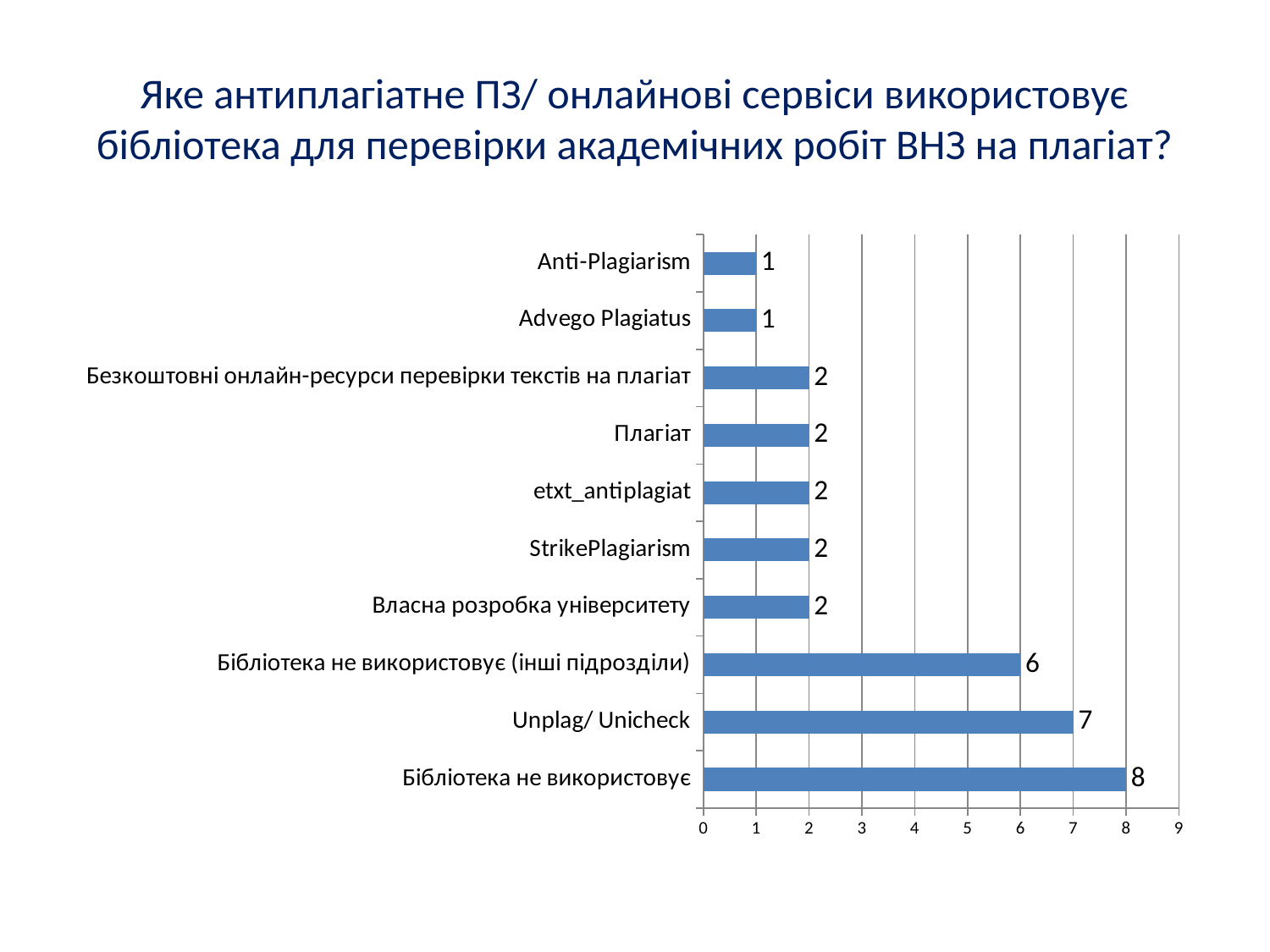
What kind of chart is shown on the slide? Bar chart What is the value for Unplag/ Unicheck? 7 What is the value for StrikePlagiarism? 2 Which category has the highest value? Бібліотека не використовує Which is larger, the value for Бібліотека не використовує (інші підрозділи) or the value for Власна розробка університету? Бібліотека не використовує (інші підрозділи) What is the value for Advego Plagiatus? 1 How many categories are shown in the chart? 10 What is the difference between the values for Бібліотека не використовує and Unplag/ Unicheck? 1 What is the difference between the values for Unplag/ Unicheck and Плагіат? 5 How many categories have a value of 2? 5 What is the highest value shown on the horizontal axis? 9 What is the value for Бібліотека не використовує (інші підрозділи)? 6